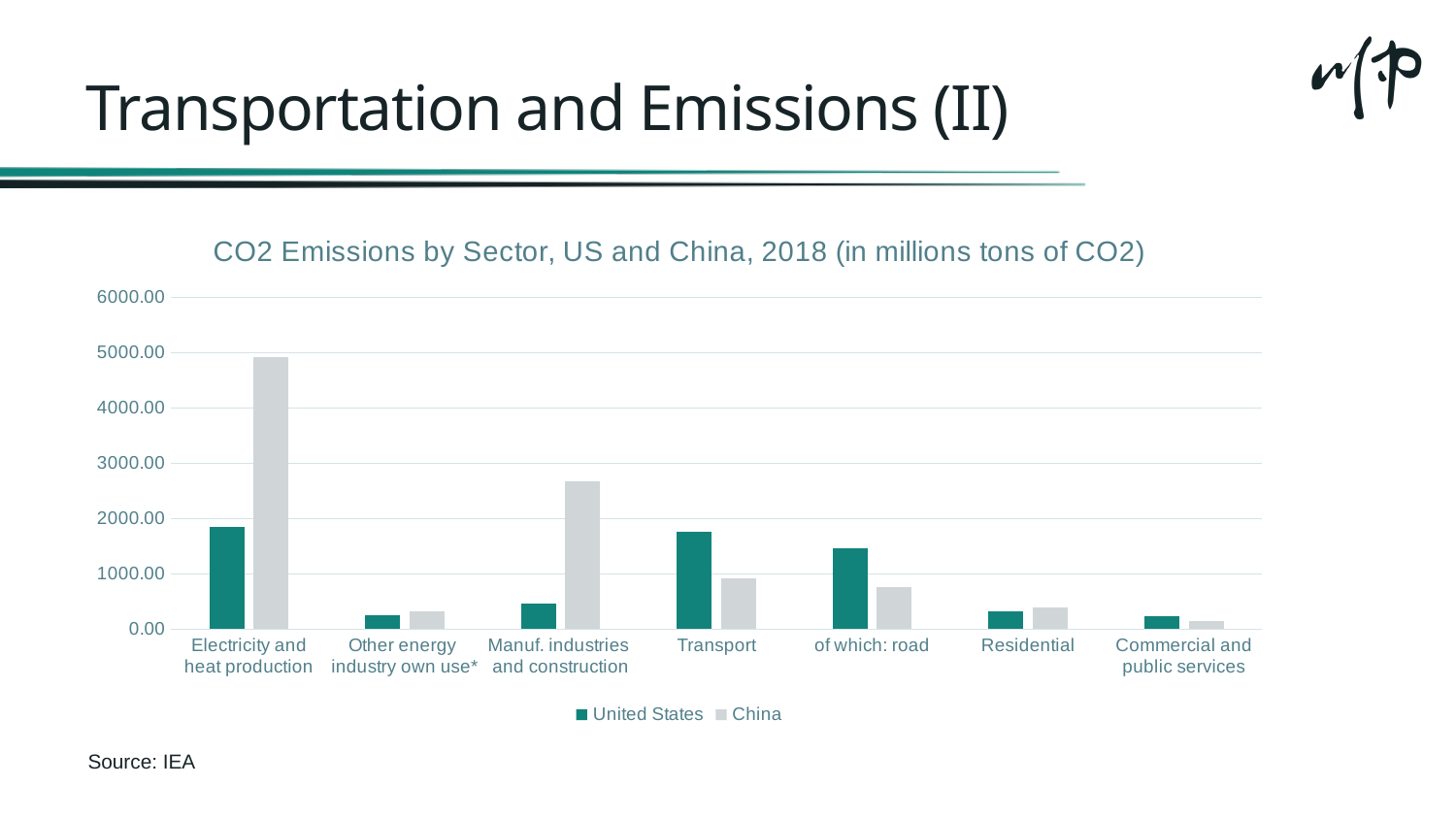
Which sector has the lowest CO2 emissions for China? Commercial and public services What kind of chart is shown on the slide? Bar chart Is the value for China in Electricity and heat production greater or less than 4000.00? greater How many series does the legend list? 2 Which sector has the highest CO2 emissions for China? Electricity and heat production For Manuf. industries and construction, which country has higher CO2 emissions, the United States or China? China Is the value for China in Manuf. industries and construction greater or less than 2000.00? greater Is the value for the United States in Manuf. industries and construction greater or less than 1000.00? less For the Transport sector, which country has higher CO2 emissions, the United States or China? United States What is the title of the chart? CO2 Emissions by Sector, US and China, 2018 (in millions tons of CO2) How many sector categories are shown on the x axis? 7